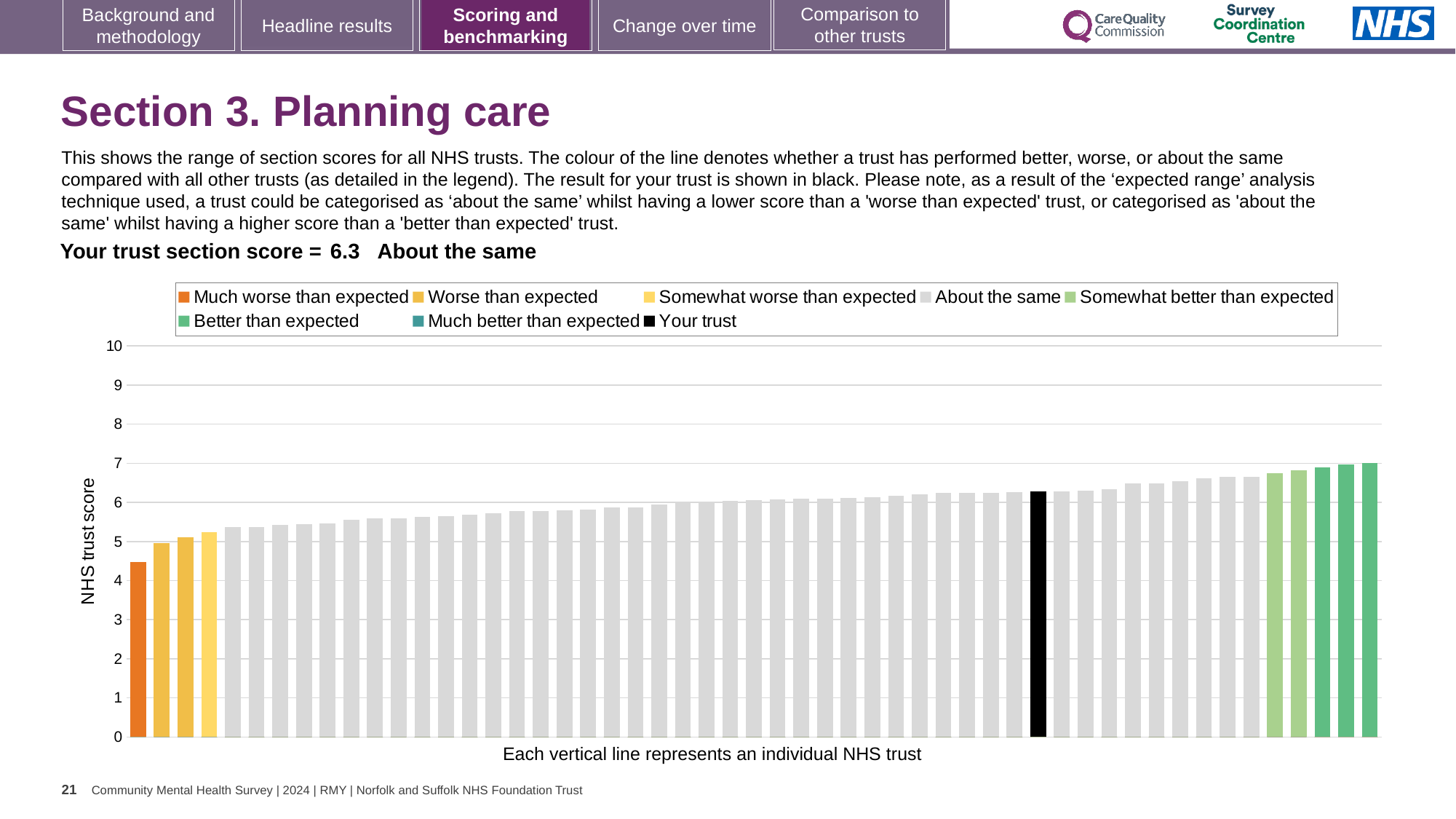
Which performance category is the trust's section score for Planning care assigned to? About the same Is the value of the black 'Your trust' bar in the Planning care chart greater or less than 6? greater Which legend category in the Planning care chart is shown in orange? Much worse than expected Do the NHS trust scores rise or fall from left to right across the Planning care chart? rise What kind of chart is used to show the NHS trust scores for Planning care? bar chart How many entries does the legend of the Planning care chart list? 8 Is the value of the lowest (orange) bar in the Planning care chart greater or less than 5? less What is the trust's section score for Planning care shown on the slide? 6.3 In the Planning care chart, is the black 'Your trust' bar higher or lower than the orange bar? higher Is the value of the lowest (orange) bar in the Planning care chart greater or less than 4? greater What colour is used for the 'Your trust' bar in the Planning care chart? black